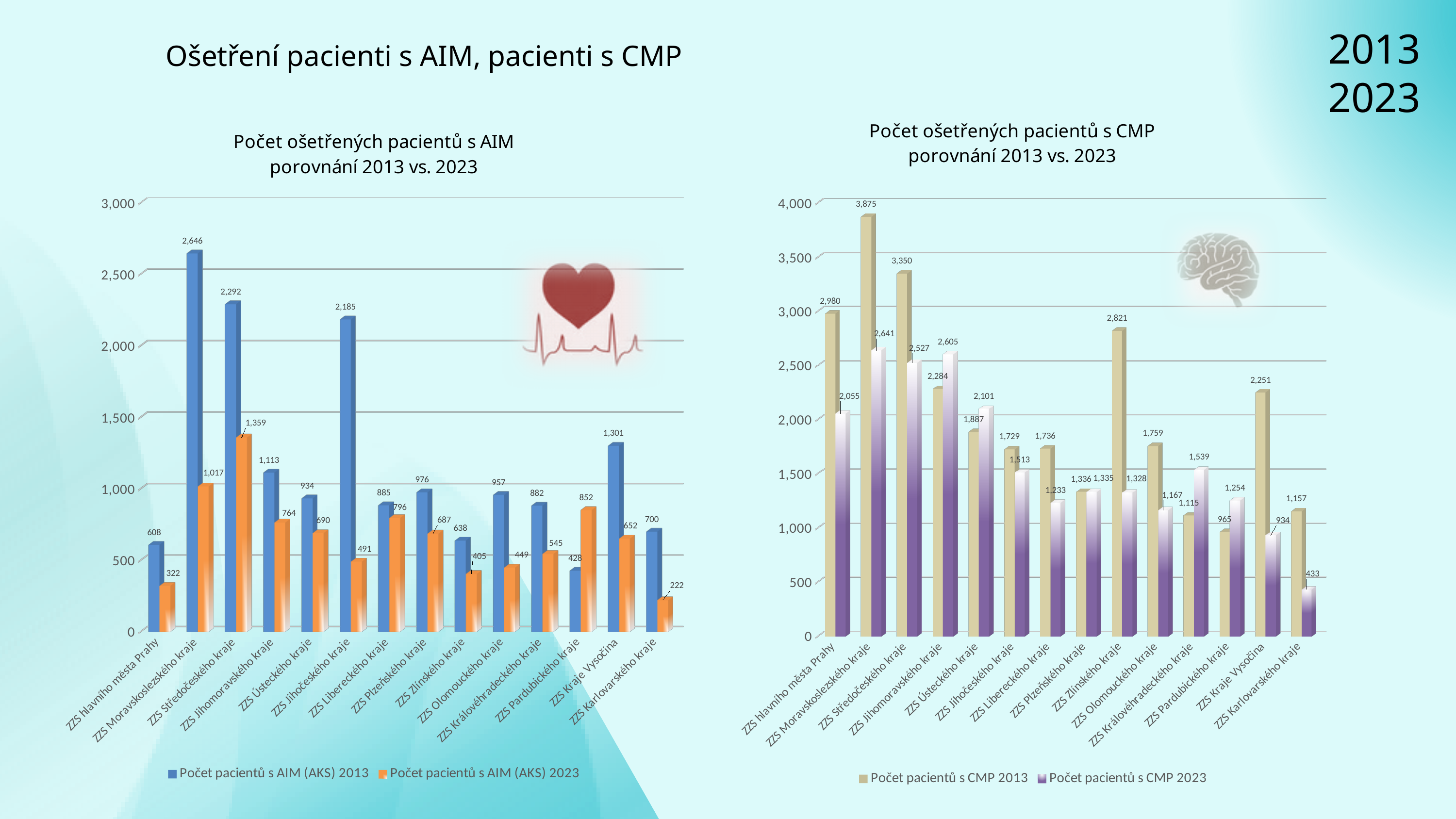
What kind of chart is 'Počet ošetřených pacientů s CMP porovnání 2013 vs. 2023'? Bar chart In the chart 'Počet ošetřených pacientů s CMP porovnání 2013 vs. 2023', how many series does the legend list? 2 In the chart 'Počet ošetřených pacientů s AIM porovnání 2013 vs. 2023', which category has the lowest value in the series 'Počet pacientů s AIM (AKS) 2023'? ZZS Karlovarského kraje In the chart 'Počet ošetřených pacientů s AIM porovnání 2013 vs. 2023', what is the value for ZZS Moravskoslezského kraje in the series 'Počet pacientů s AIM (AKS) 2013'? 2,646 In the chart 'Počet ošetřených pacientů s CMP porovnání 2013 vs. 2023', what is the difference between the 2013 and 2023 values for ZZS Kraje Vysočina? 1,317 In the chart 'Počet ošetřených pacientů s CMP porovnání 2013 vs. 2023', what is the value for ZZS Moravskoslezského kraje in the series 'Počet pacientů s CMP 2013'? 3,875 In the chart 'Počet ošetřených pacientů s AIM porovnání 2013 vs. 2023', how many categories are shown on the x axis? 14 In the chart 'Počet ošetřených pacientů s AIM porovnání 2013 vs. 2023', what is the difference between the 2013 and 2023 values for ZZS Jihočeského kraje? 1,694 In the chart 'Počet ošetřených pacientů s CMP porovnání 2013 vs. 2023', which category has the highest value in the series 'Počet pacientů s CMP 2023'? ZZS Moravskoslezského kraje In the chart 'Počet ošetřených pacientů s AIM porovnání 2013 vs. 2023', which is larger for ZZS Pardubického kraje: the 2013 value or the 2023 value? 2023 value In the chart 'Počet ošetřených pacientů s AIM porovnání 2013 vs. 2023', what is the value for ZZS Pardubického kraje in the series 'Počet pacientů s AIM (AKS) 2023'? 852 In the chart 'Počet ošetřených pacientů s CMP porovnání 2013 vs. 2023', what is the value for ZZS Karlovarského kraje in the series 'Počet pacientů s CMP 2023'? 433